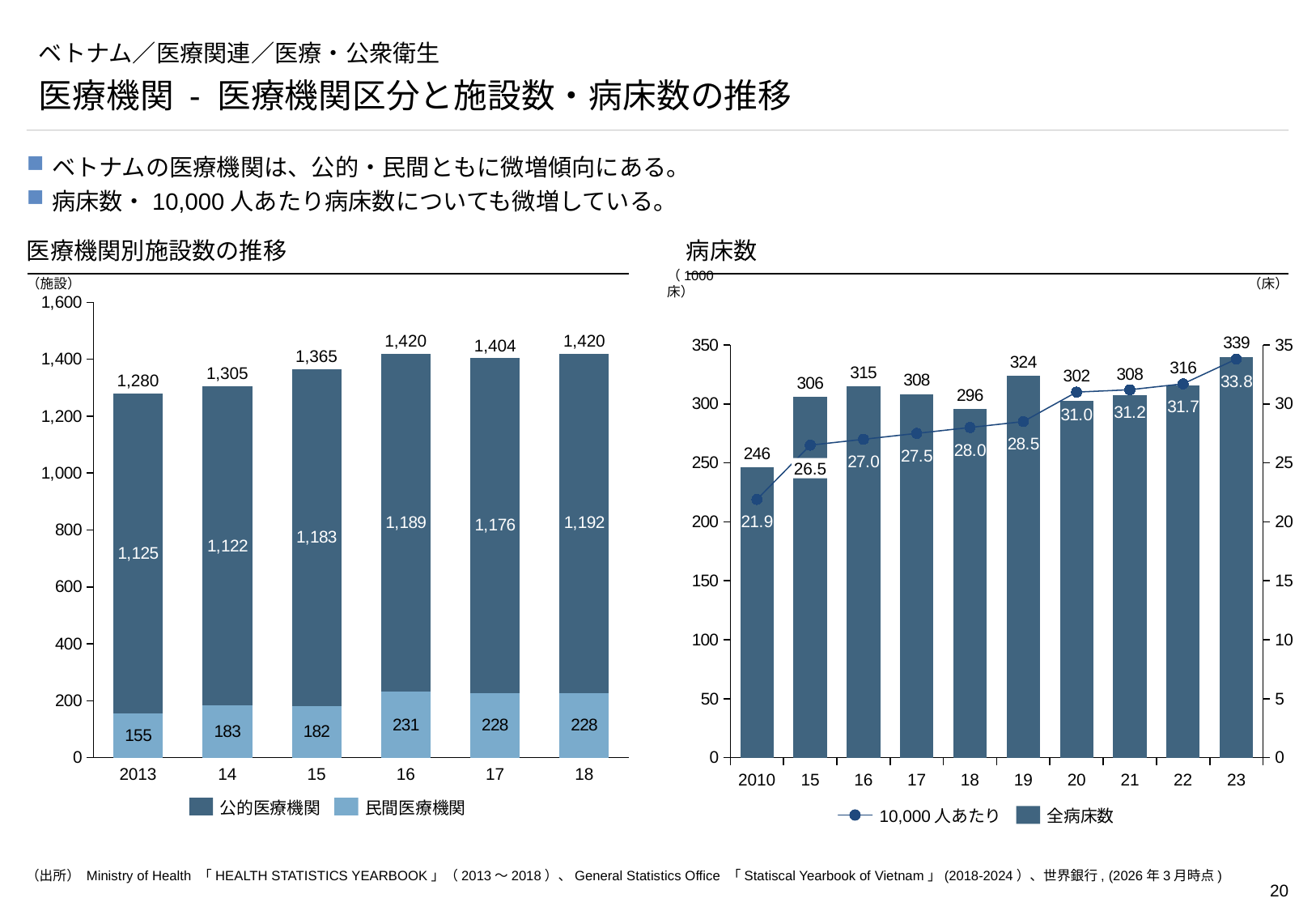
In the 病床数 chart, what is the value for 10,000 人あたり in 2010? 21.9 In the 医療機関別施設数の推移 chart, what is the difference between the 民間医療機関 values for 16 and 2013? 76 In the 医療機関別施設数の推移 chart, what is the value for 公的医療機関 in 2013? 1,125 In the 病床数 chart, which year has the highest value for 全病床数? 23 In the 医療機関別施設数の推移 chart, how many series does the legend list? 2 In the 医療機関別施設数の推移 chart, what is the total number of facilities shown for 15? 1,365 In the 病床数 chart, is the value for 全病床数 in 18 larger or smaller than in 17? smaller In the 医療機関別施設数の推移 chart, what is the value for 民間医療機関 in 16? 231 In the 病床数 chart, how many years are shown on the x axis? 10 In the 病床数 chart, does the 10,000 人あたり line rise or fall from 2010 to 23? rise In the 病床数 chart, what is the value for 全病床数 in 19? 324 In the 医療機関別施設数の推移 chart, which year has the lowest value for 民間医療機関? 2013